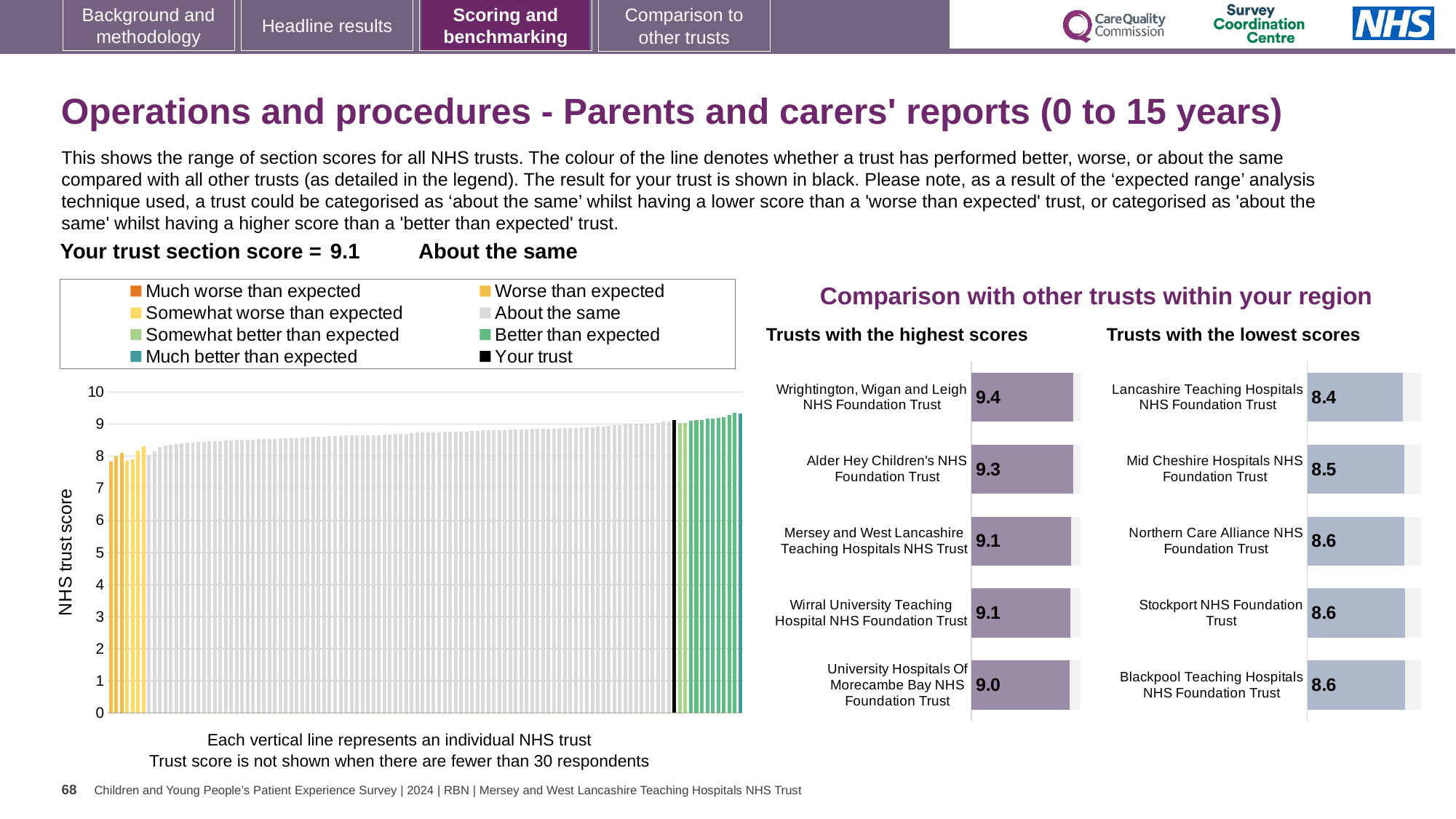
How many entries does the legend of the main 'NHS trust score' chart on the left list? 8 In the 'Trusts with the lowest scores' chart, what is the score for Mid Cheshire Hospitals NHS Foundation Trust? 8.5 In the 'Trusts with the highest scores' chart, what is the score for Alder Hey Children's NHS Foundation Trust? 9.3 In the 'Trusts with the lowest scores' chart, which trust has the lowest score? Lancashire Teaching Hospitals NHS Foundation Trust Which has a higher score: Alder Hey Children's NHS Foundation Trust in the highest scores chart or Mid Cheshire Hospitals NHS Foundation Trust in the lowest scores chart? Alder Hey Children's NHS Foundation Trust In the main 'NHS trust score' chart on the left, what is the section score for your trust (shown in black)? 9.1 In the 'Trusts with the lowest scores' chart, what is the difference between the scores of Northern Care Alliance NHS Foundation Trust and Lancashire Teaching Hospitals NHS Foundation Trust? 0.2 In the 'Trusts with the highest scores' chart, which trust has the highest score? Wrightington, Wigan and Leigh NHS Foundation Trust In the 'Trusts with the highest scores' chart, what is the score for Wrightington, Wigan and Leigh NHS Foundation Trust? 9.4 In the 'Trusts with the lowest scores' chart, what is the score for Lancashire Teaching Hospitals NHS Foundation Trust? 8.4 In the 'Trusts with the highest scores' chart, what is the difference between the scores of Wrightington, Wigan and Leigh NHS Foundation Trust and University Hospitals Of Morecambe Bay NHS Foundation Trust? 0.4 How many trusts are shown in the 'Trusts with the highest scores' chart? 5